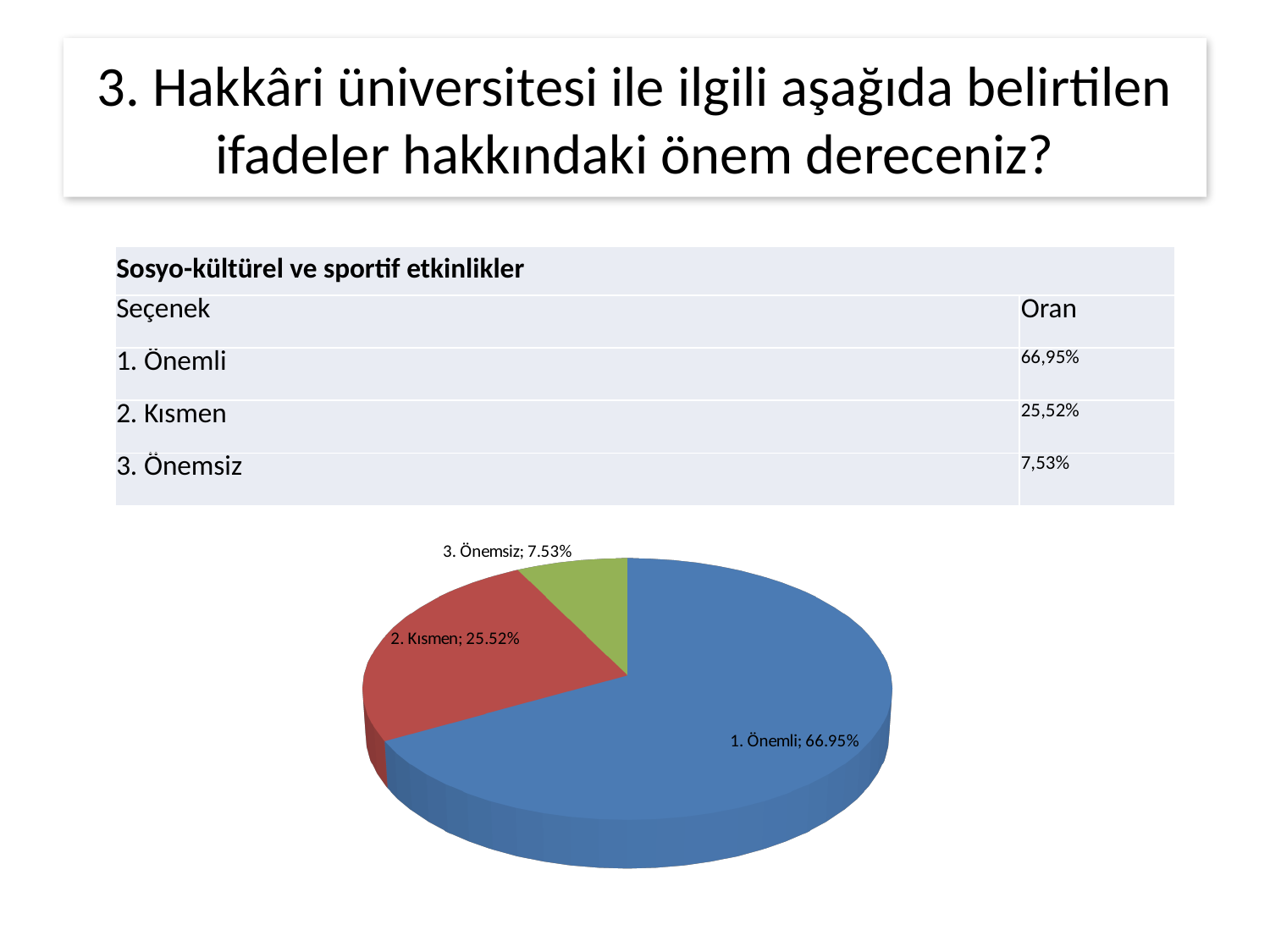
Which category has the smallest slice in the pie chart? 3. Önemsiz Which is larger in the pie chart, "2. Kısmen" or "3. Önemsiz"? 2. Kısmen What colour is the slice for "2. Kısmen" in the pie chart? red What is the value for "2. Kısmen" in the pie chart? 25.52% What is the difference between the values for "2. Kısmen" and "3. Önemsiz" in the pie chart? 17.99% What share of the pie does "1. Önemli" represent? 66.95% How many slices does the pie chart have? 3 What is the value for "3. Önemsiz" in the pie chart? 7.53% Which category has the largest slice in the pie chart? 1. Önemli What is the value for "1. Önemli" in the pie chart? 66.95% What is the difference between the values for "1. Önemli" and "2. Kısmen" in the pie chart? 41.43% What kind of chart is shown on the slide? pie chart